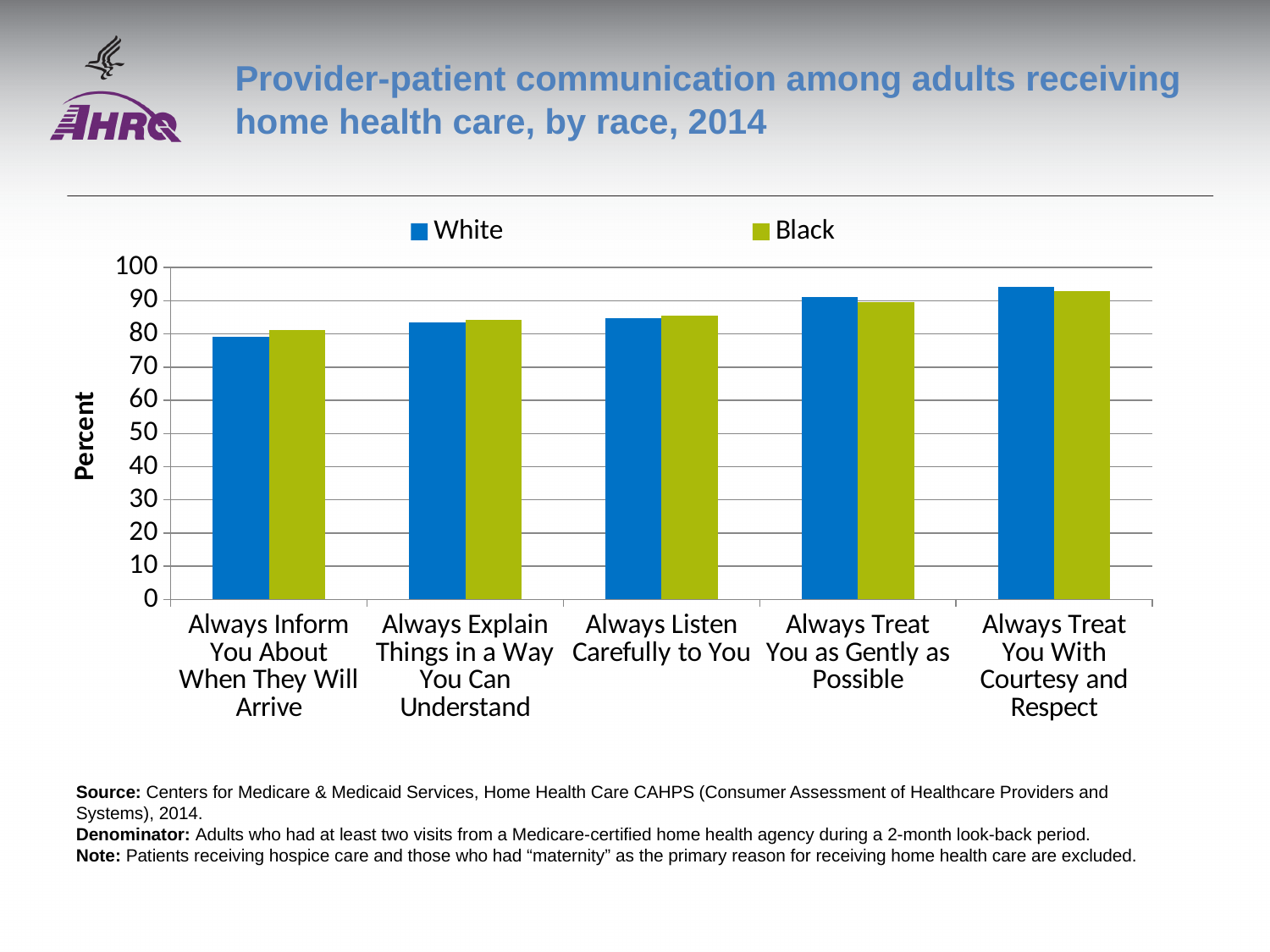
Is the Black value for Always Listen Carefully to You greater or less than 80? greater Which category has the highest value for Black? Always Treat You With Courtesy and Respect For White, which is larger: Always Inform You About When They Will Arrive or Always Treat You as Gently as Possible? Always Treat You as Gently as Possible How many categories are shown on the x axis? 5 Which category has the lowest value for Black? Always Inform You About When They Will Arrive Which category has the lowest value for White? Always Inform You About When They Will Arrive Is the White value for Always Treat You With Courtesy and Respect greater or less than 90? greater What kind of chart is shown on the slide? Bar chart Is the White value for Always Inform You About When They Will Arrive greater or less than 90? less Which category has the highest value for White? Always Treat You With Courtesy and Respect Do the values generally rise or fall from left to right across the categories? Rise How many series does the legend list? 2